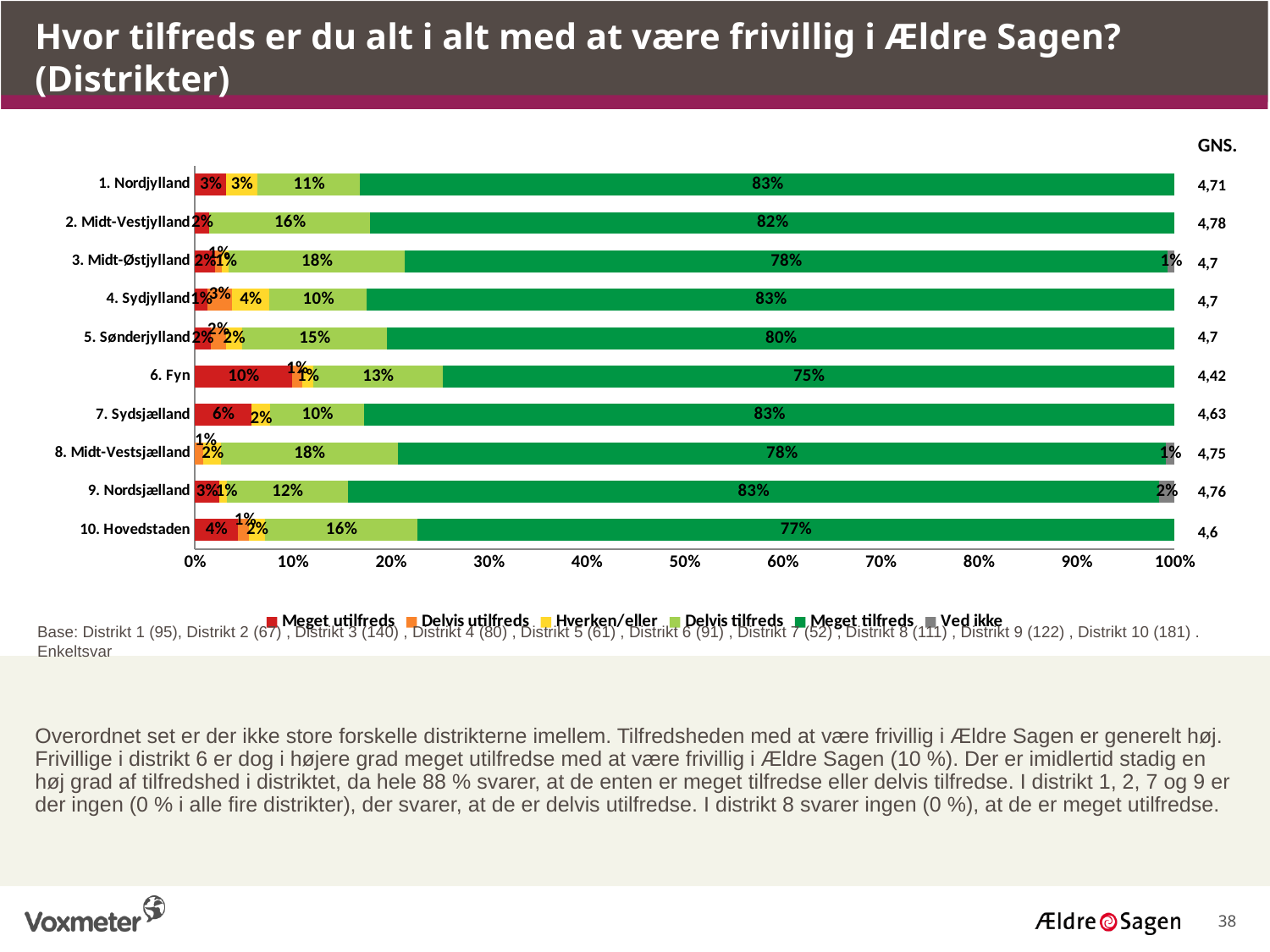
How many districts are shown in the chart? 10 What percentage of volunteers in 3. Midt-Østjylland answered "Delvis tilfreds"? 18% What is the "Meget utilfreds" share for 7. Sydsjælland? 6% Which district has the highest "Meget utilfreds" share? 6. Fyn What is the difference in percentage points between the "Meget tilfreds" share for 1. Nordjylland and for 6. Fyn? 8 percentage points What is the GNS. value shown for 6. Fyn? 4,42 How many series does the legend list? 6 What percentage of volunteers in 6. Fyn answered "Meget tilfreds"? 75% Which district has the lowest "Meget tilfreds" share? 6. Fyn Which district has the highest GNS. value? 2. Midt-Vestjylland What kind of chart is shown on the slide? Stacked bar chart Which has a larger "Delvis tilfreds" share, 2. Midt-Vestjylland or 4. Sydjylland? 2. Midt-Vestjylland